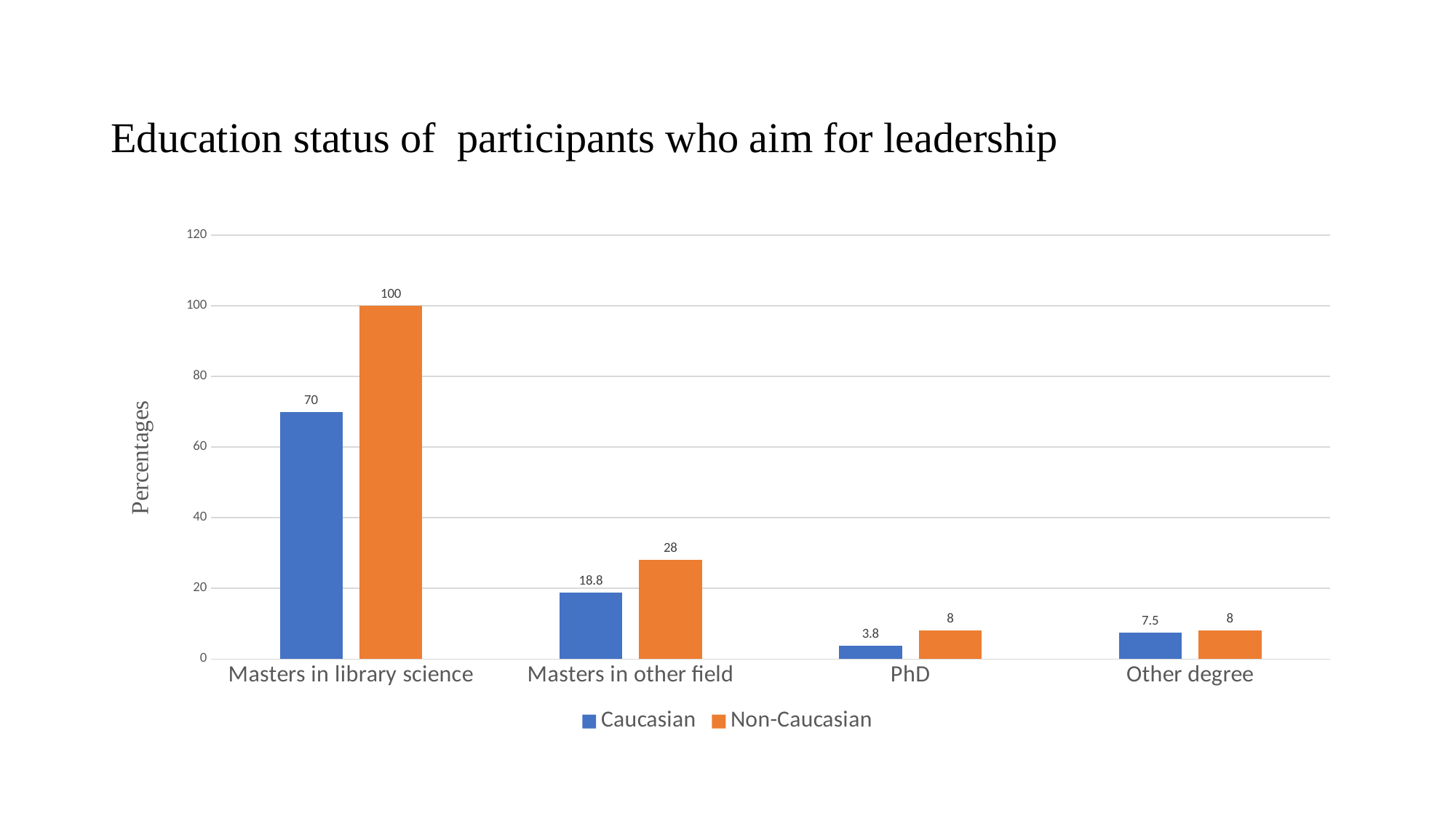
Which category has the lowest Caucasian value? PhD What is the Non-Caucasian value for Masters in other field? 28 What is the Non-Caucasian value for Other degree? 8 What is the Caucasian value for PhD? 3.8 Which is larger for Masters in other field, the Caucasian or the Non-Caucasian value? Non-Caucasian How many categories are shown on the x axis? 4 What is the Caucasian value for Masters in library science? 70 Which category has the highest Non-Caucasian value? Masters in library science What is the difference between the Non-Caucasian and Caucasian values for Masters in library science? 30 How many series does the legend list? 2 What is the label on the vertical axis? Percentages What kind of chart is shown on the slide? Bar chart